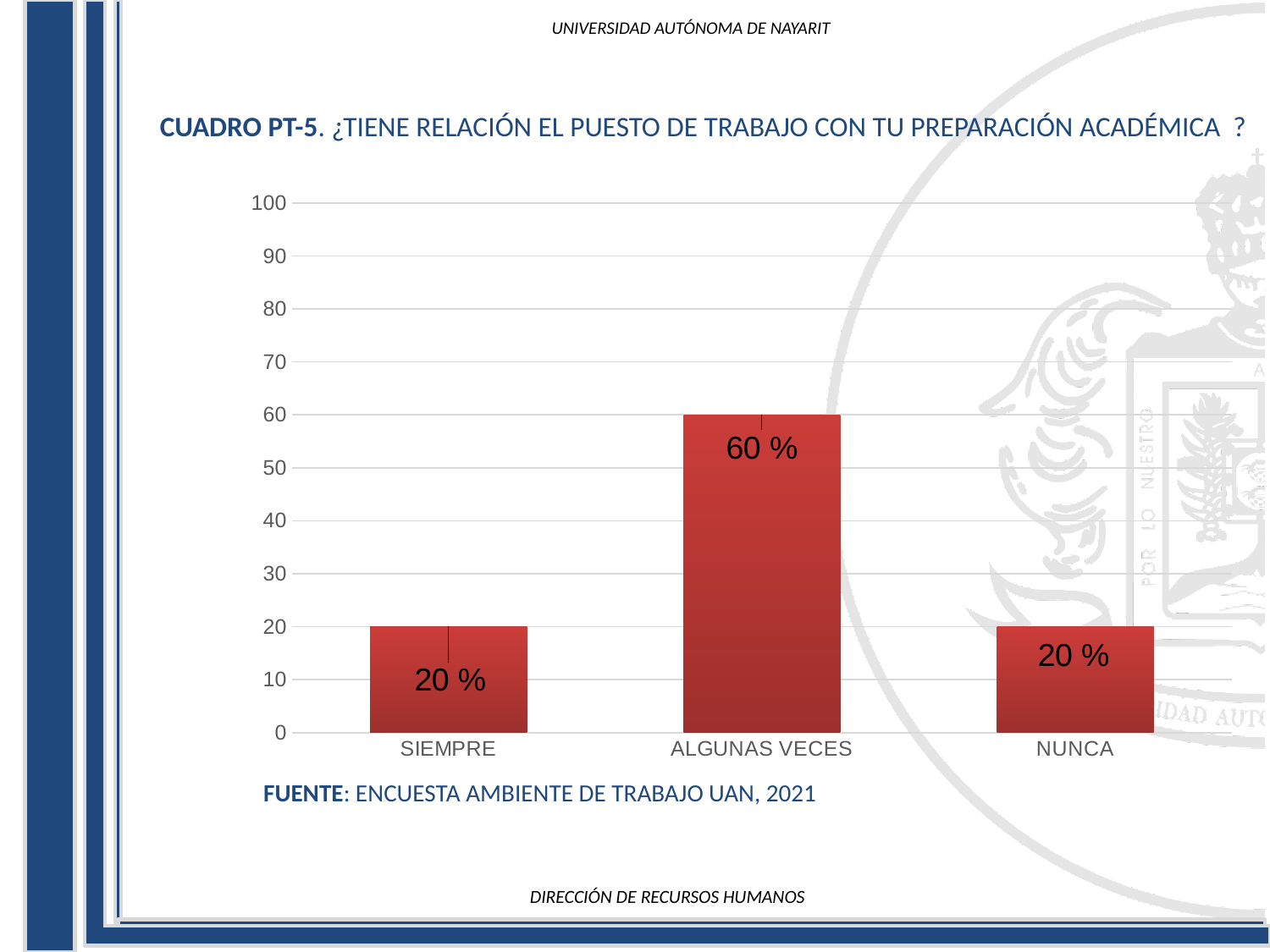
Is the value for SIEMPRE greater or less than 30? less Is the value for ALGUNAS VECES greater or less than 50? greater Which is larger, the value for ALGUNAS VECES or the value for NUNCA? ALGUNAS VECES What source is cited below the chart? ENCUESTA AMBIENTE DE TRABAJO UAN, 2021 What is the value for SIEMPRE? 20 % Which category has the highest value? ALGUNAS VECES What is the value for NUNCA? 20 % What is the maximum value shown on the y axis? 100 What is the difference between the values for ALGUNAS VECES and SIEMPRE? 40 % What kind of chart is shown on the slide? bar chart How many categories are shown on the x axis? 3 What is the value for ALGUNAS VECES? 60 %